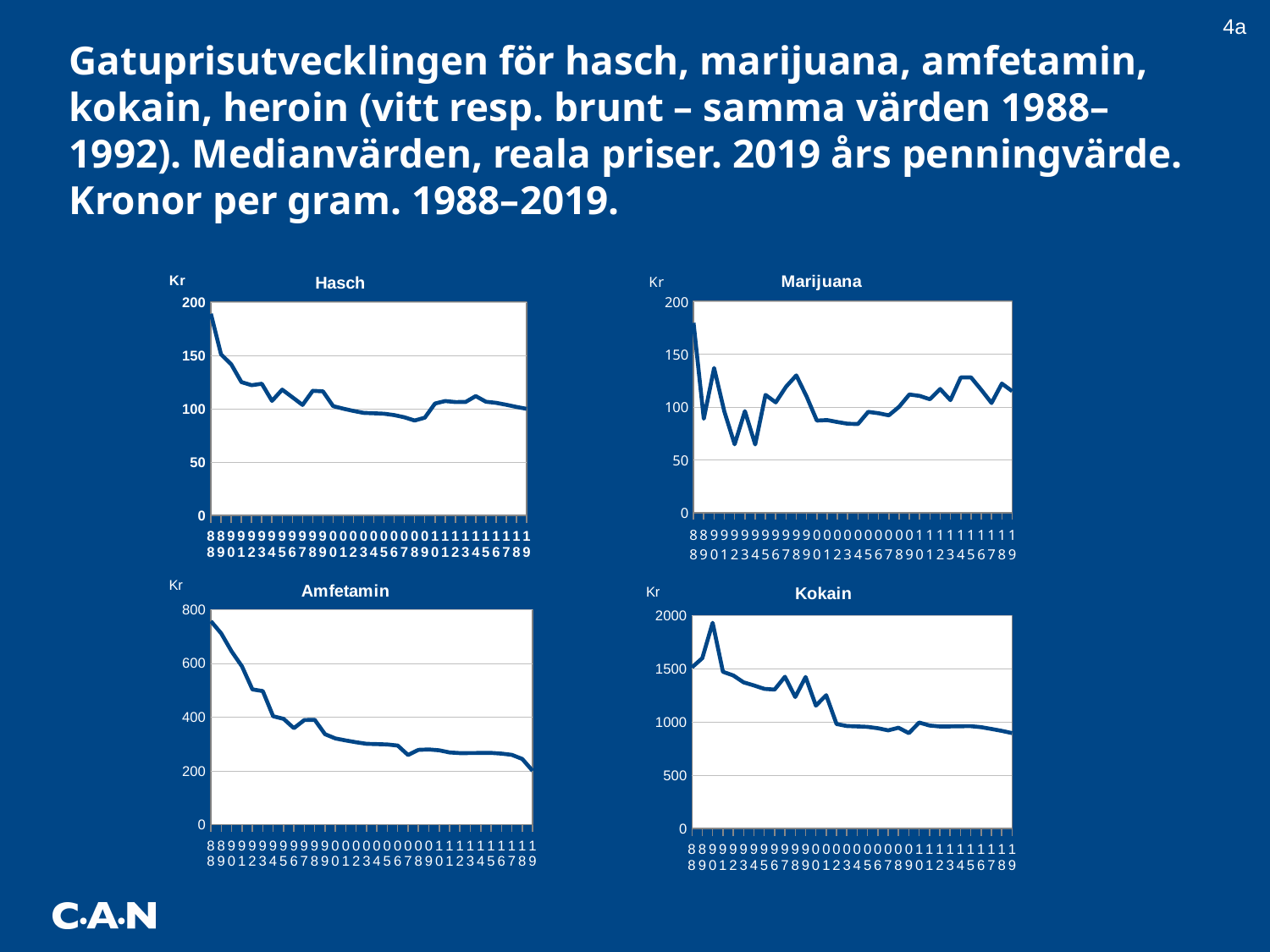
In the Kokain chart, is the value for 1990 greater or less than 1500? greater What kind of chart is the Hasch chart? line chart In the Kokain chart, do the values generally rise or fall across the period shown? fall In the Marijuana chart, is the value for 1992 greater or less than 100? less In the Hasch chart, is the value for 1988 greater or less than 150? greater In the Kokain chart, which year has the highest value? 1990 In the Amfetamin chart, do the values generally rise or fall from 1988 to 2019? fall In the Hasch chart, which year has the highest value? 1988 In the Amfetamin chart, which year has the lowest value? 2019 What unit label is shown on the y axis of the Kokain chart? Kr In the Amfetamin chart, which is larger, the value for 1988 or the value for 2019? 1988